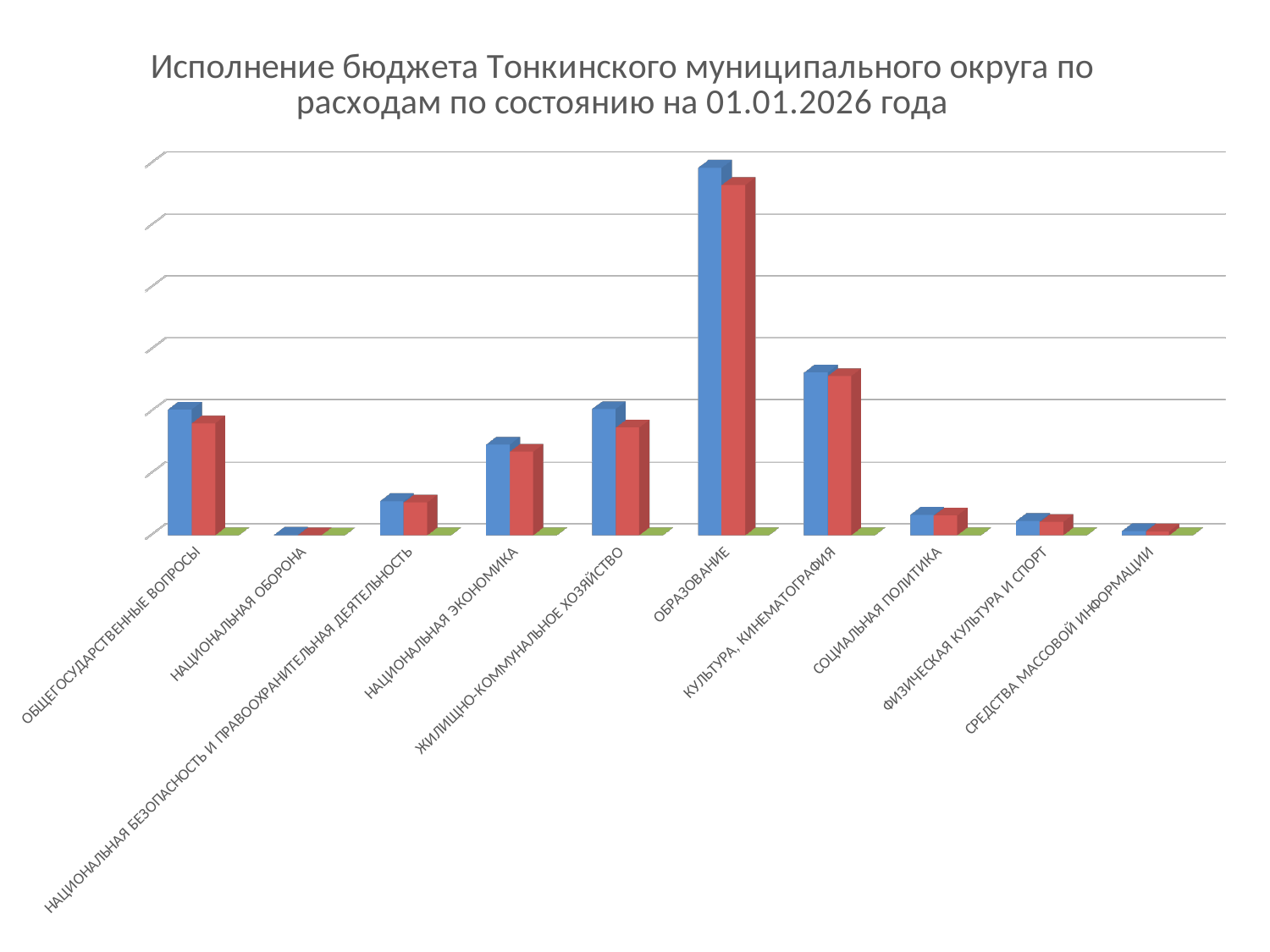
What kind of chart is shown on the slide? bar chart Which category has the higher red bar: НАЦИОНАЛЬНАЯ ЭКОНОМИКА or ФИЗИЧЕСКАЯ КУЛЬТУРА И СПОРТ? НАЦИОНАЛЬНАЯ ЭКОНОМИКА Which category has the higher blue bar: ОБЩЕГОСУДАРСТВЕННЫЕ ВОПРОСЫ or НАЦИОНАЛЬНАЯ ЭКОНОМИКА? ОБЩЕГОСУДАРСТВЕННЫЕ ВОПРОСЫ Which category has the highest bars in the chart? ОБРАЗОВАНИЕ What is the title of the chart? Исполнение бюджета Тонкинского муниципального округа по расходам по состоянию на 01.01.2026 года Which category has the higher blue bar: ЖИЛИЩНО-КОММУНАЛЬНОЕ ХОЗЯЙСТВО or СОЦИАЛЬНАЯ ПОЛИТИКА? ЖИЛИЩНО-КОММУНАЛЬНОЕ ХОЗЯЙСТВО How many categories are shown on the x axis of the chart? 10 Does the chart display a legend? No